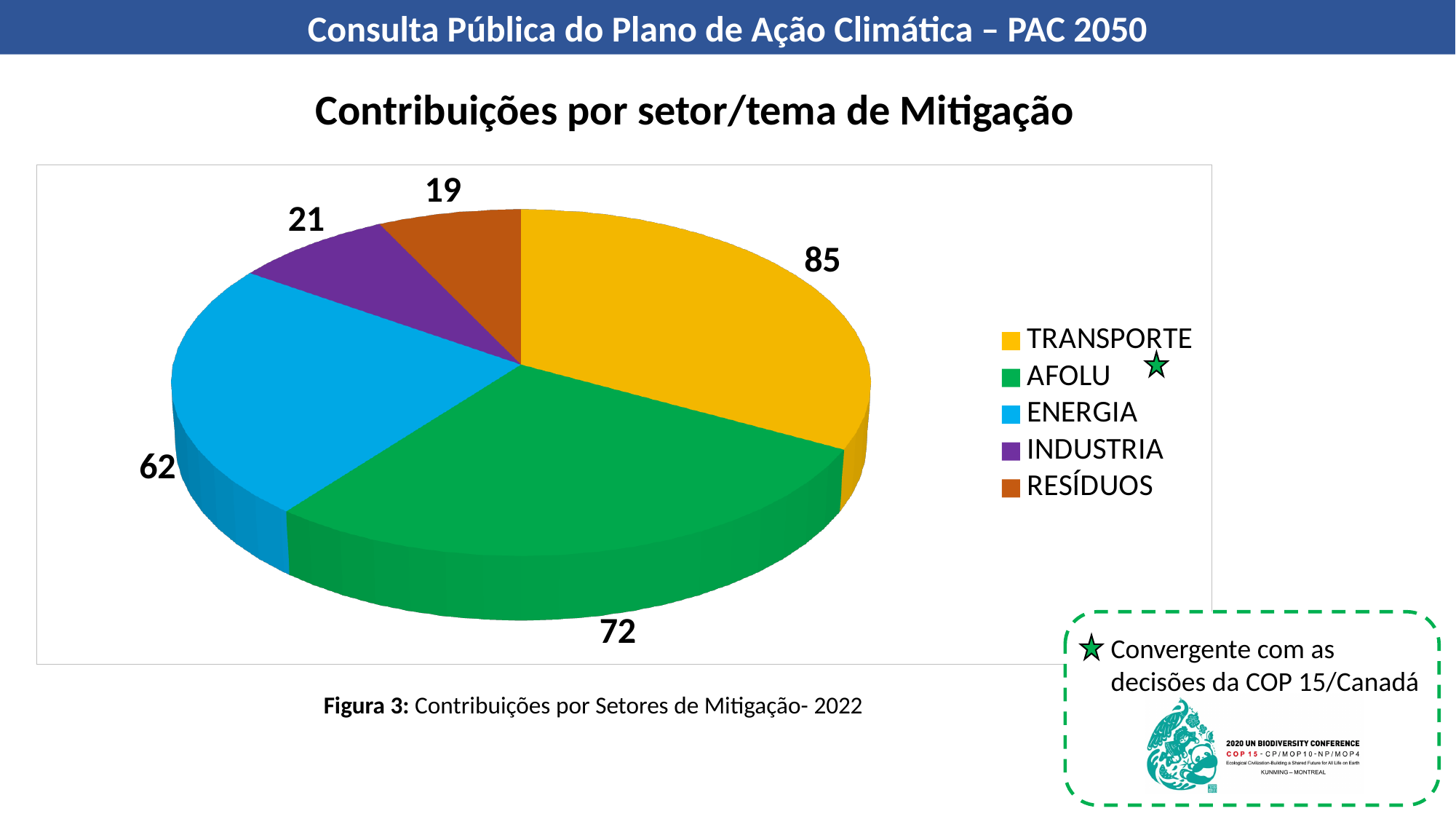
What is the title of the chart? Contribuições por setor/tema de Mitigação What is the difference between the values for TRANSPORTE and AFOLU? 13 What is the value for AFOLU? 72 Which is larger, the value for ENERGIA or the value for INDUSTRIA? ENERGIA Which sector has the highest value? TRANSPORTE What is the value for ENERGIA? 62 Which sector has the lowest value? RESÍDUOS What is the value for RESÍDUOS? 19 What is the total of all the values in the pie chart? 259 What type of chart is shown on the slide? pie chart What is the value for TRANSPORTE? 85 How many sectors are shown in the pie chart? 5